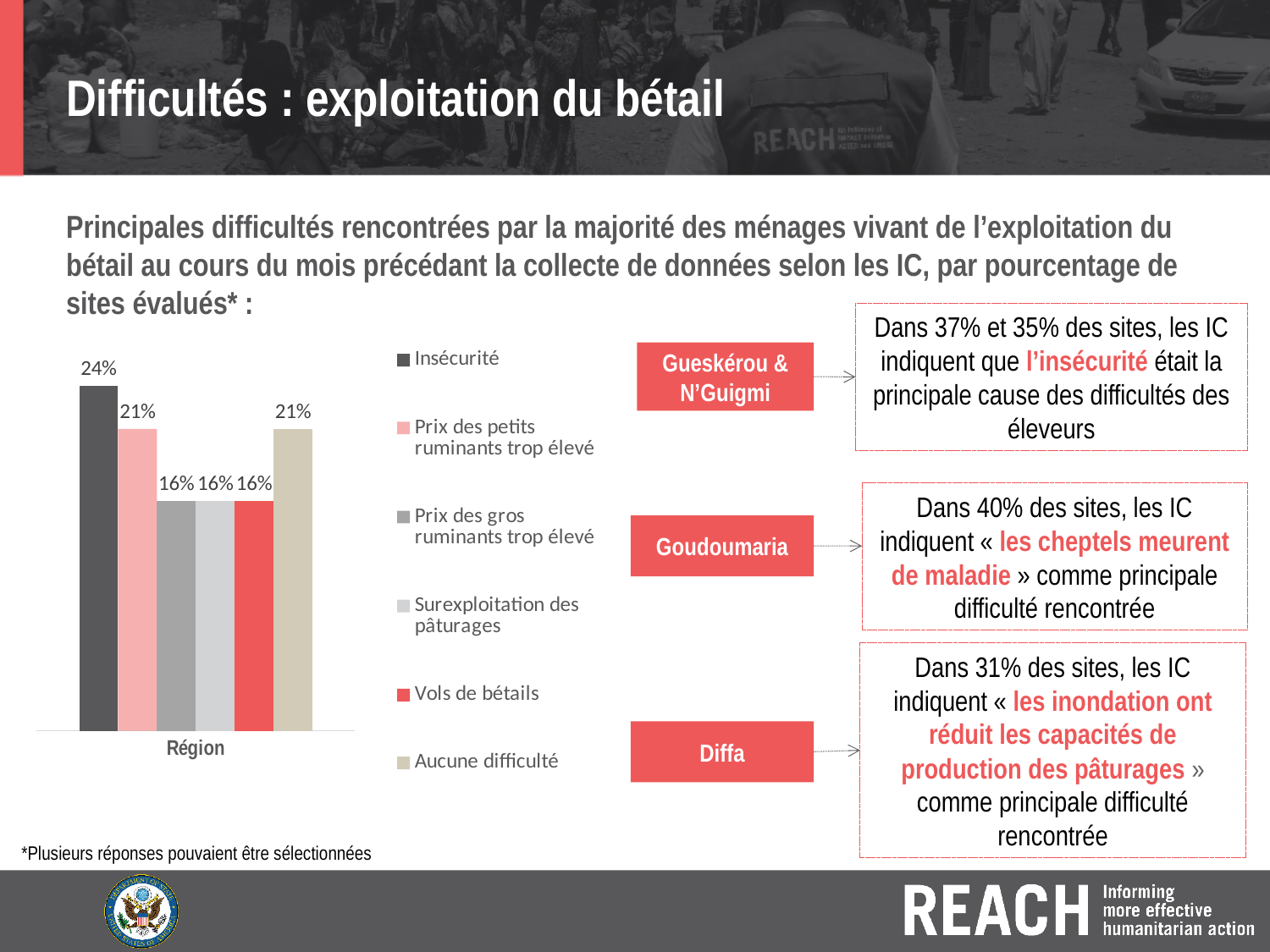
What is the value for Prix des petits ruminants trop élevé? 21% What kind of chart is shown on the slide? bar chart How many series does the chart legend list? 6 How many series share the value 16%? 3 Which is larger, the value for Insécurité or the value for Aucune difficulté? Insécurité What is the value for Insécurité? 24% Which series has the highest value in the chart? Insécurité What colour is the bar for Vols de bétails? red What is the value for Vols de bétails? 16% What is the category label shown on the x axis of the chart? Région What is the difference between the values for Insécurité and Surexploitation des pâturages? 8% What is the value for Aucune difficulté? 21%